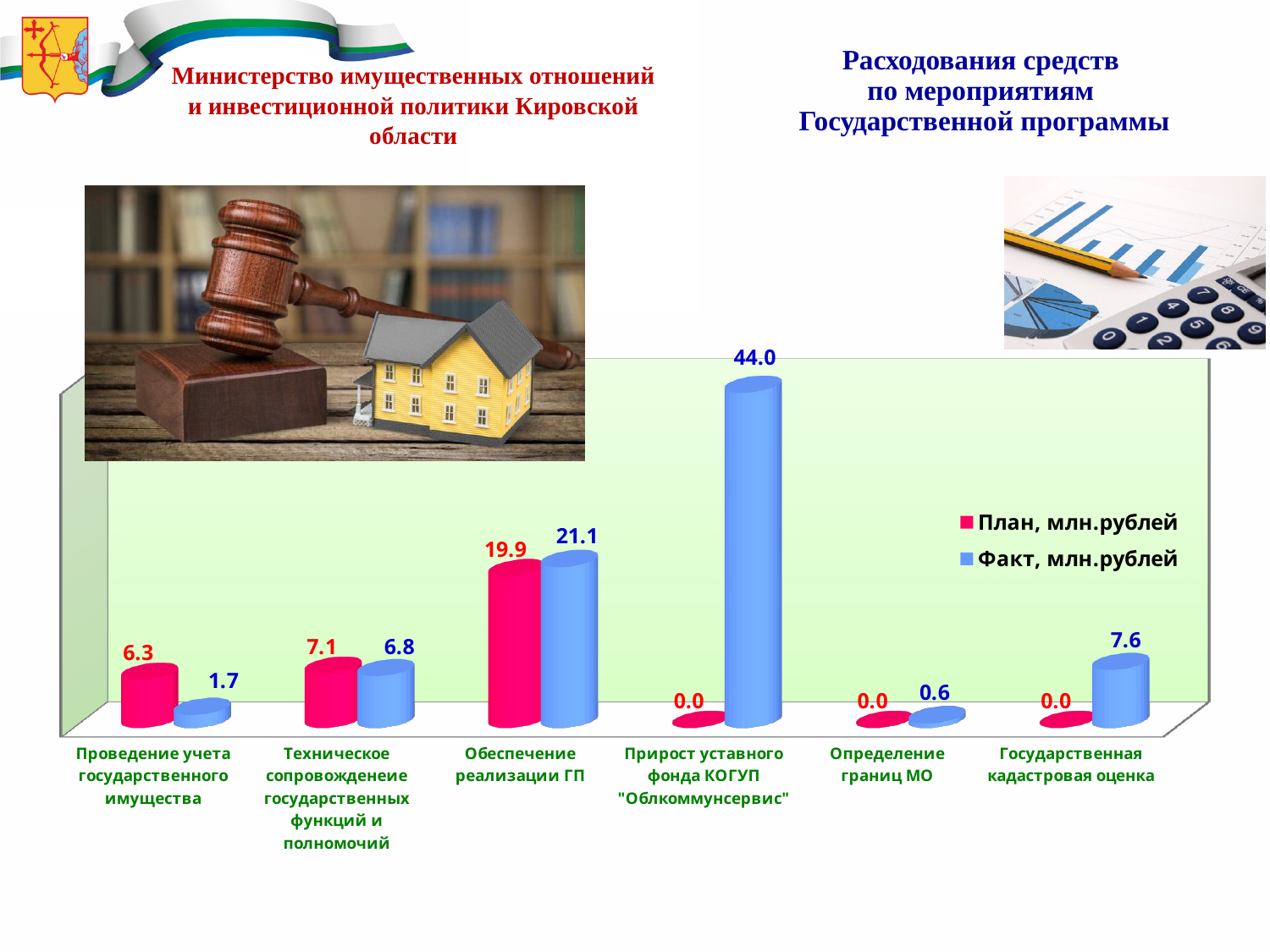
What colour are the bars for the Факт, млн.рублей series? Blue What kind of chart is shown on the slide? Bar chart Which is larger for Обеспечение реализации ГП, the План value or the Факт value? Факт What is the План value for Обеспечение реализации ГП? 19.9 What is the Факт value for Прирост уставного фонда КОГУП "Облкоммунсервис"? 44.0 How many categories are shown on the x axis? 6 Which category has the lowest non-zero Факт value? Определение границ МО What is the difference between the План and Факт values for Проведение учета государственного имущества? 4.6 How many series does the legend list? 2 Which category has the highest Факт value? Прирост уставного фонда КОГУП "Облкоммунсервис" What is the План value for Проведение учета государственного имущества? 6.3 What is the Факт value for Государственная кадастровая оценка? 7.6